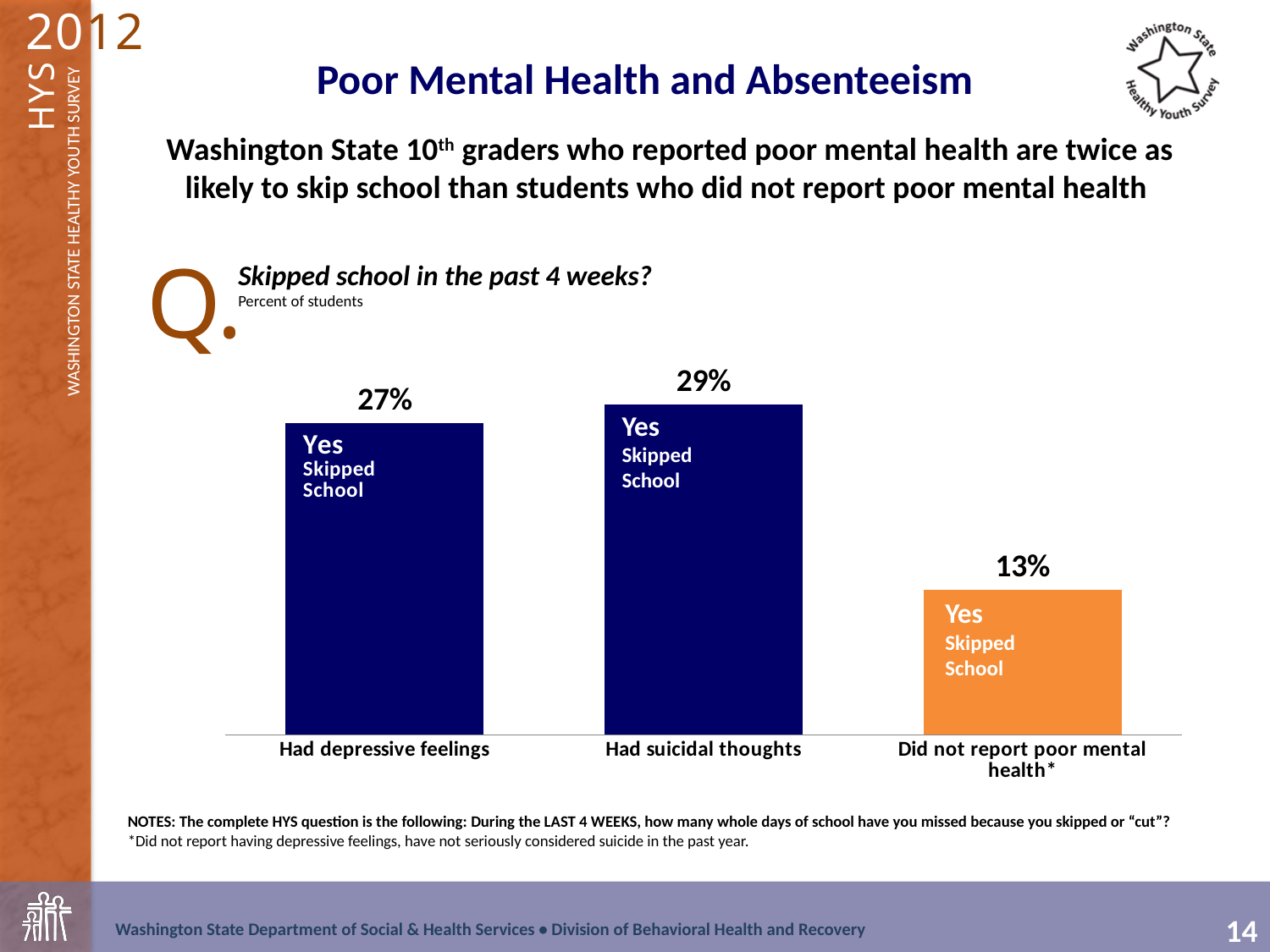
Which is larger: the percentage for 'Had depressive feelings' or for 'Did not report poor mental health*'? Had depressive feelings Which category has the lowest percentage of students who skipped school? Did not report poor mental health* What is the difference in percentage points between students who had suicidal thoughts and students who had depressive feelings? 2 How many categories are shown on the chart? 3 What question does the chart answer, as stated above the chart? Skipped school in the past 4 weeks? What percentage of students who had suicidal thoughts skipped school in the past 4 weeks? 29% What percentage of students who had depressive feelings skipped school in the past 4 weeks? 27% Which category has the highest percentage of students who skipped school? Had suicidal thoughts What kind of chart is shown on the slide? Bar chart Which bar is coloured orange rather than dark blue? Did not report poor mental health* What percentage of students who did not report poor mental health skipped school in the past 4 weeks? 13% What is the difference in percentage points between students who had suicidal thoughts and students who did not report poor mental health? 16